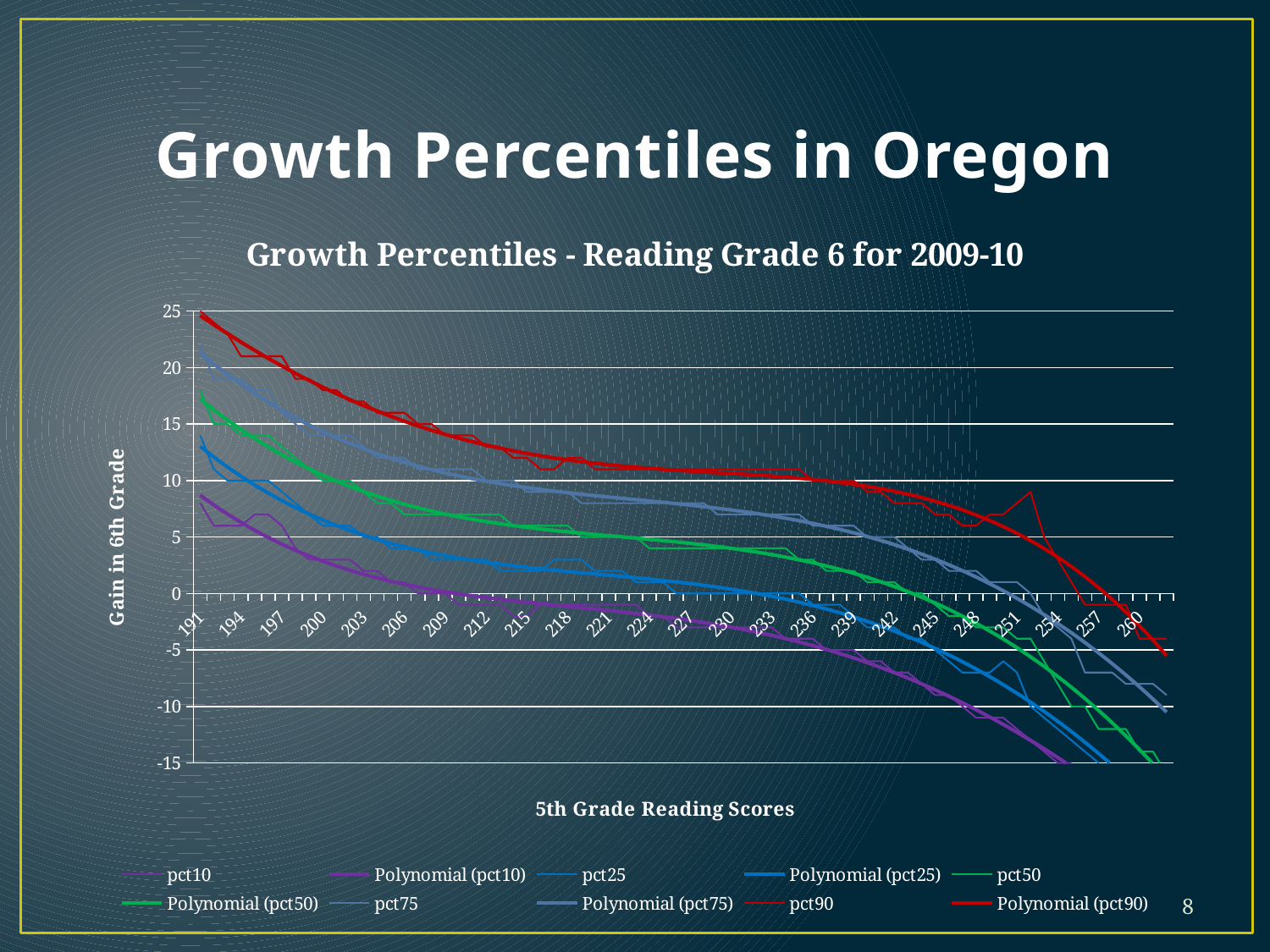
How many series does the legend list? 10 At a 5th grade reading score of 191, is the value for pct90 greater or less than 20? greater Do the values of the pct90 series rise or fall as the 5th Grade Reading Scores increase along the x axis? Fall At a 5th grade reading score of 191, is the value for pct10 greater or less than 5? greater At a 5th grade reading score of 191, is the value for pct50 greater or less than 15? greater What is the title of the chart? Growth Percentiles - Reading Grade 6 for 2009-10 Which series has the lowest value at a 5th grade reading score of 191? pct10 Which series has the highest value at a 5th grade reading score of 191? pct90 At a 5th grade reading score of 191, which is larger, the value for pct75 or the value for pct25? pct75 What is the label of the vertical axis? Gain in 6th Grade What kind of chart is shown on the slide? Line chart